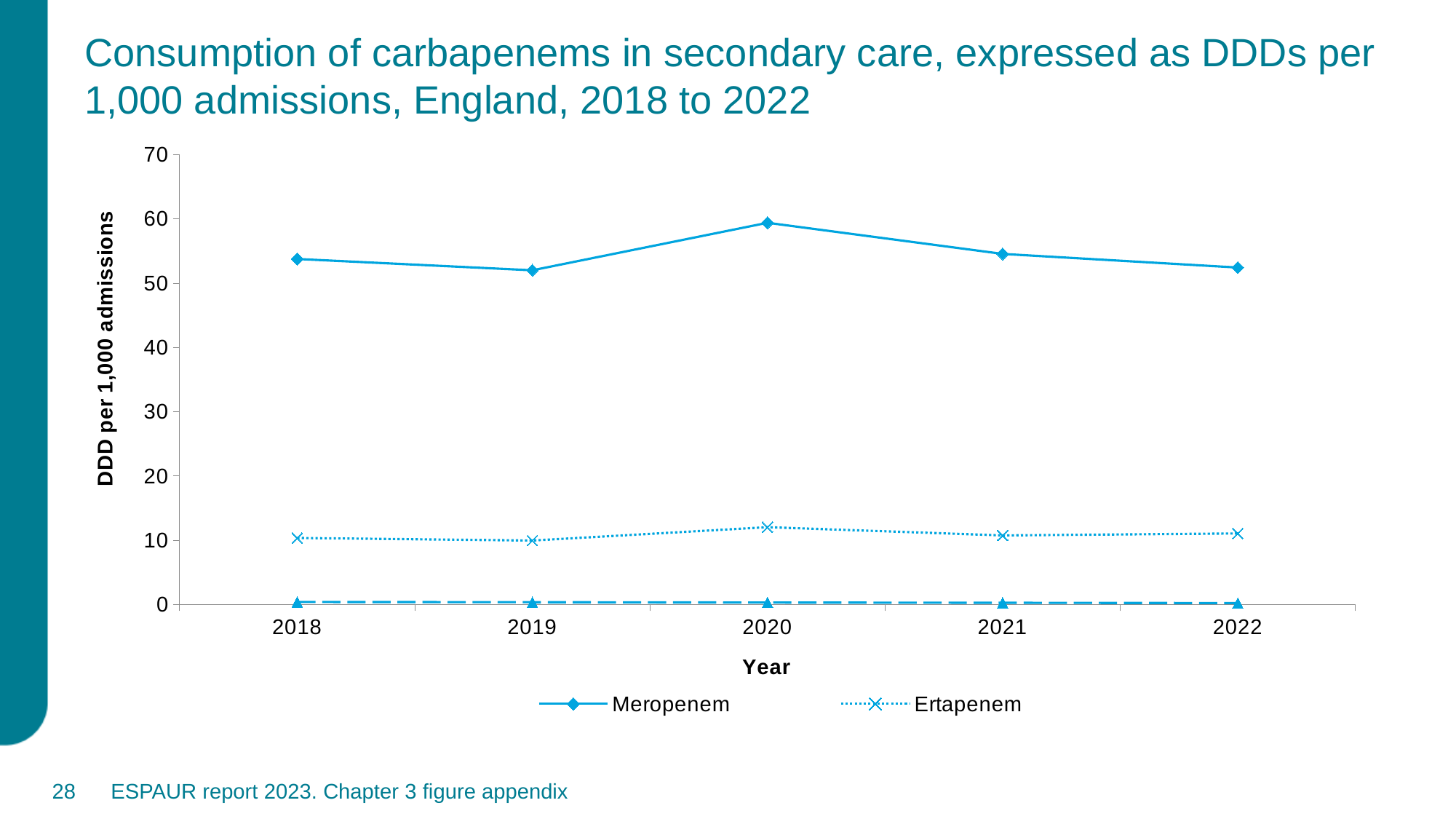
Which is larger, the Meropenem value for 2019 or for 2020? 2020 Is the Meropenem value for 2019 greater or less than 60? less In which year is the Meropenem value highest? 2020 In which year is the Ertapenem value highest? 2020 Is the Ertapenem value for 2020 greater or less than 10? greater Is the Meropenem value for 2020 greater or less than 50? greater What kind of chart is shown on the slide? line chart How many years are plotted along the x axis? 5 What is the title of the y axis? DDD per 1,000 admissions How many series does the legend list? 2 Does the Meropenem line rise or fall from 2020 to 2022? fall